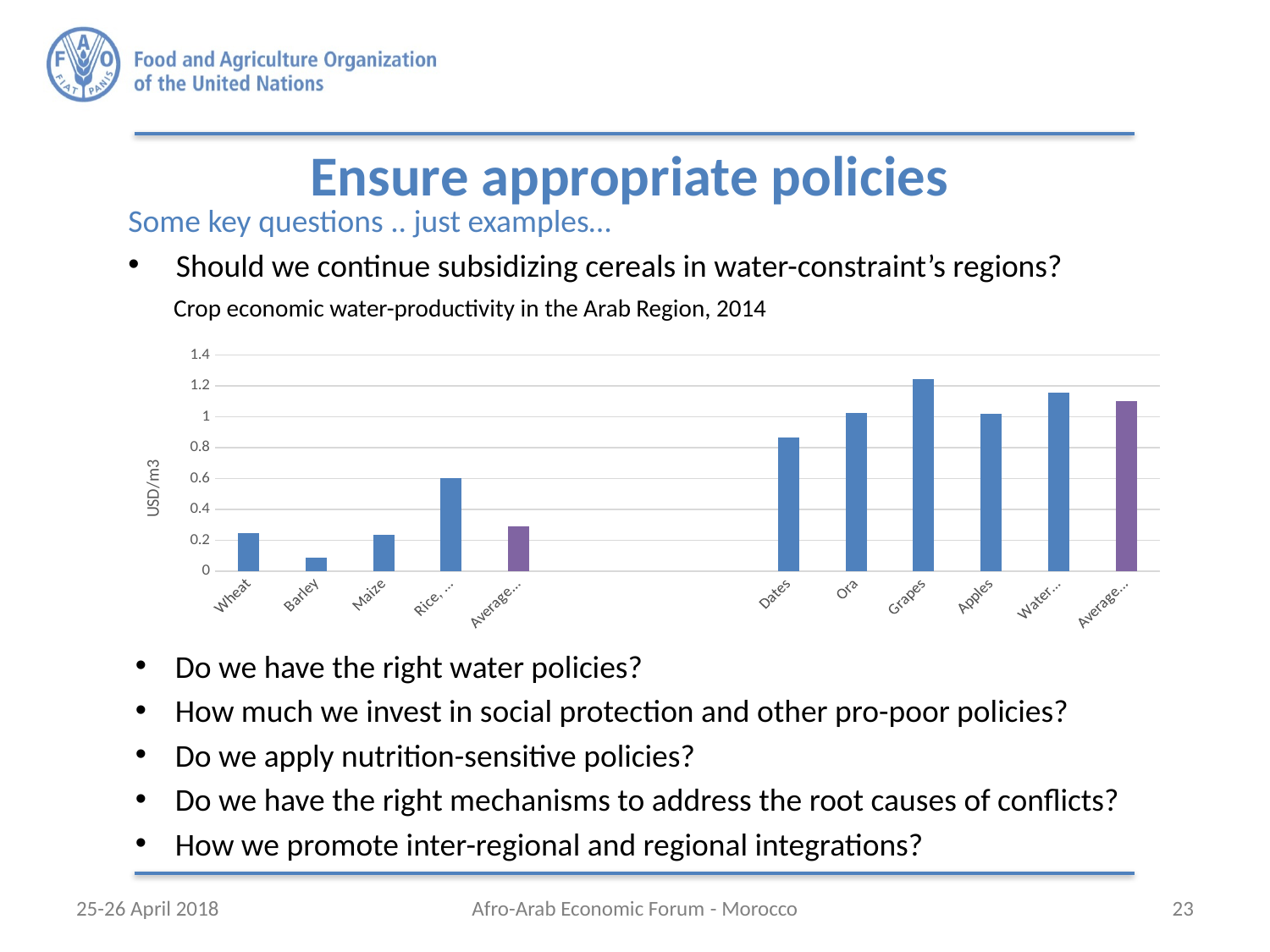
How many bars are plotted in the chart? 11 What is the title of the chart? Crop economic water-productivity in the Arab Region, 2014 Is the value for Apples greater or less than 0.8? greater Is the value for Grapes greater or less than 1? greater Is the value for Barley greater or less than 0.2? less What type of chart is shown on the slide? bar chart Which crop has the lowest economic water-productivity in the chart? Barley What is the label on the vertical axis of the chart? USD/m3 Which has a higher value, Dates or Maize? Dates Which crop has the highest economic water-productivity in the chart? Grapes